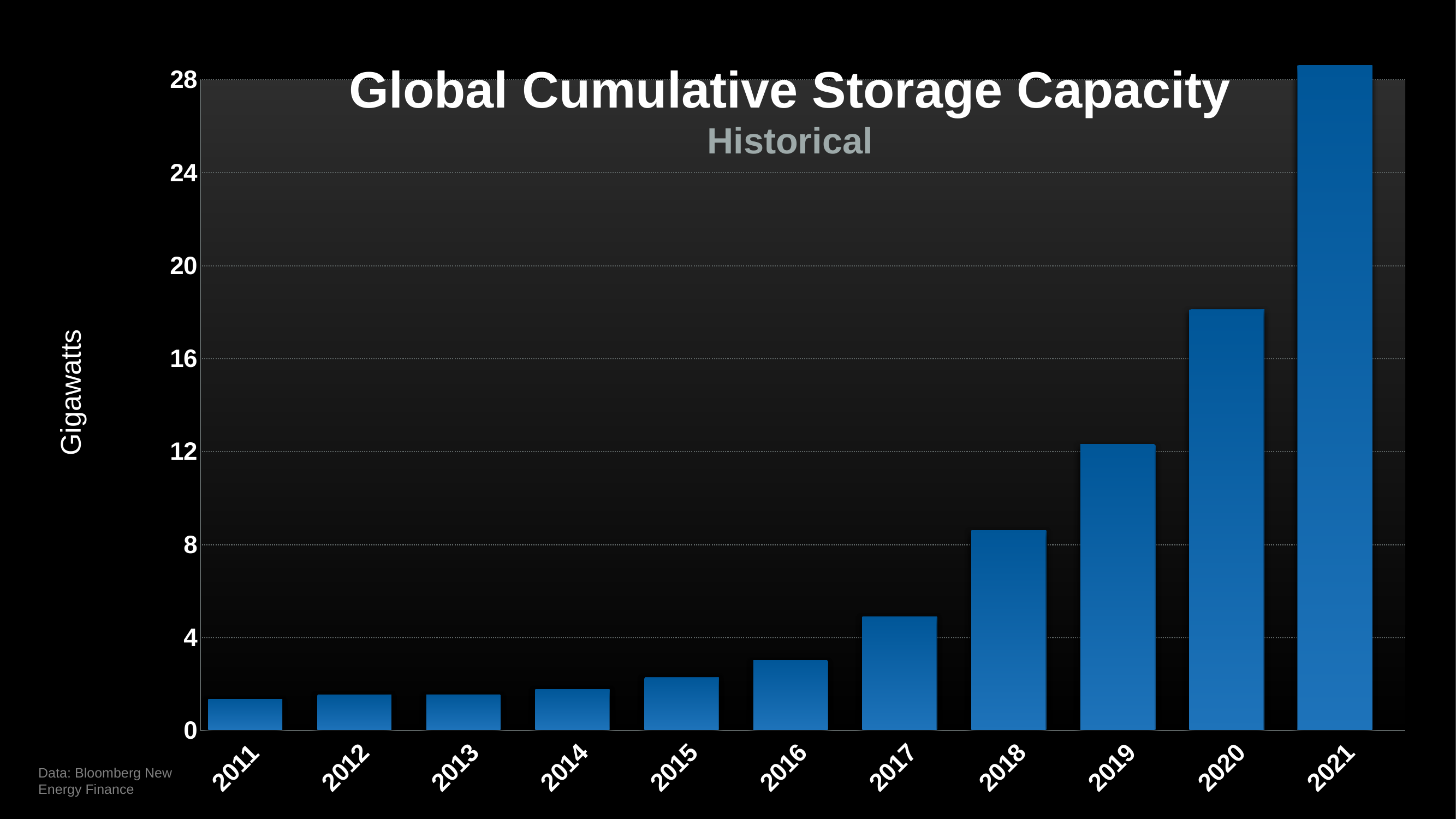
Do the values rise or fall from 2011 to 2021? rise What is the label on the y axis? Gigawatts Which year has the highest global cumulative storage capacity? 2021 How many years are plotted on the x axis? 11 Is the value for 2021 greater or less than 24? greater What kind of chart is shown on the slide? bar chart Is the value for 2019 greater or less than 8? greater Is the value for 2020 greater or less than 16? greater Which is larger, the value for 2020 or the value for 2019? 2020 What is the title of the chart? Global Cumulative Storage Capacity